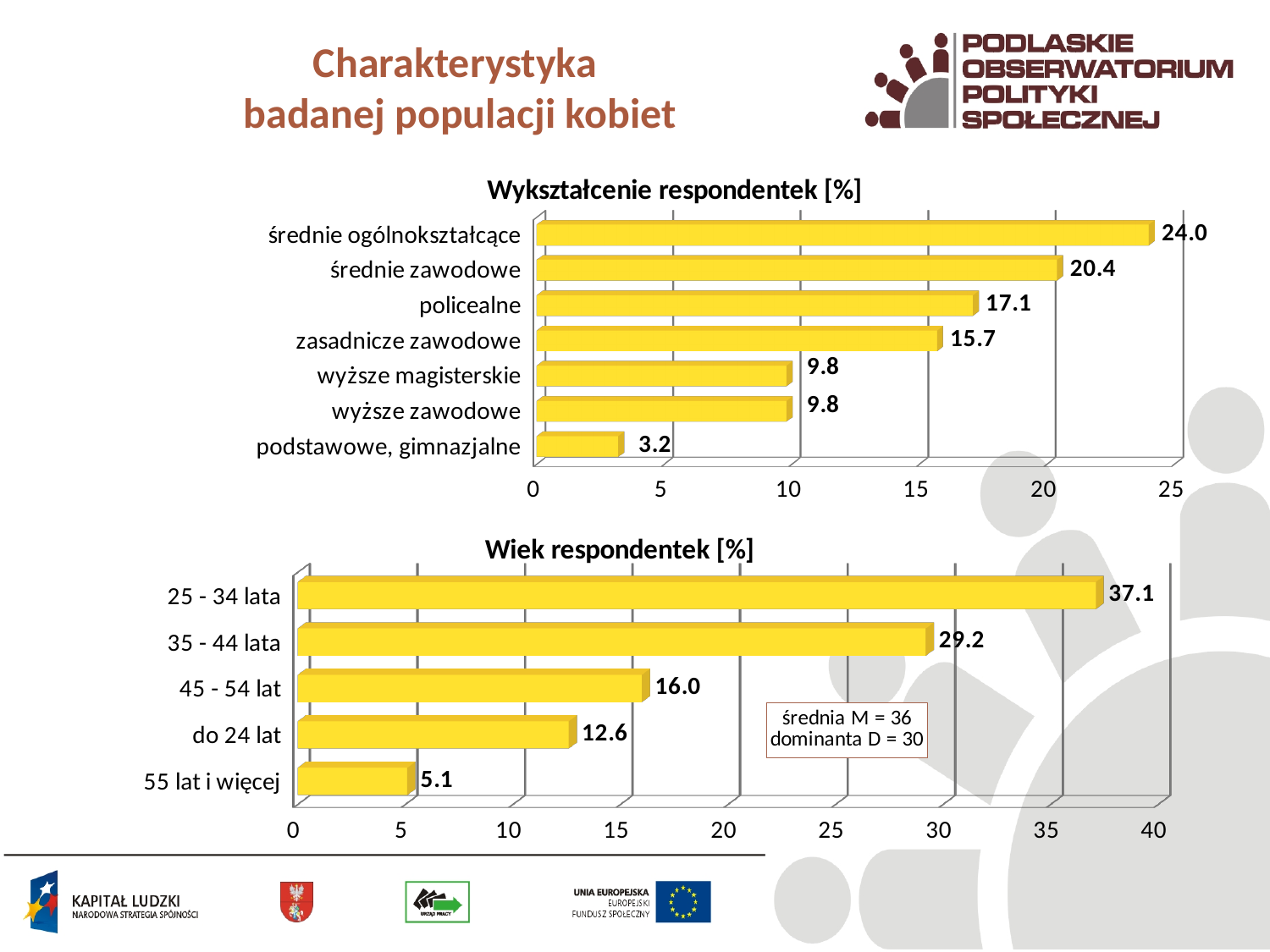
In the chart titled "Wykształcenie respondentek [%]", what is the value for "policealne"? 17.1 In the chart titled "Wykształcenie respondentek [%]", which category has the highest value? średnie ogólnokształcące In the chart titled "Wiek respondentek [%]", which age group has the lowest value? 55 lat i więcej In the chart titled "Wiek respondentek [%]", what is the value for "45 - 54 lat"? 16.0 In the chart titled "Wiek respondentek [%]", which age group has the highest value? 25 - 34 lata In the chart titled "Wykształcenie respondentek [%]", which category has the lowest value? podstawowe, gimnazjalne In the chart titled "Wykształcenie respondentek [%]", what is the difference between "średnie ogólnokształcące" and "średnie zawodowe"? 3.6 In the chart titled "Wykształcenie respondentek [%]", how many categories are shown? 7 In the chart titled "Wiek respondentek [%]", which is larger: the value for "do 24 lat" or the value for "55 lat i więcej"? do 24 lat In the chart titled "Wykształcenie respondentek [%]", is the value for "zasadnicze zawodowe" greater or less than 15? greater In the chart titled "Wiek respondentek [%]", what is the difference between "25 - 34 lata" and "35 - 44 lata"? 7.9 What type of chart is the chart titled "Wiek respondentek [%]"? bar chart